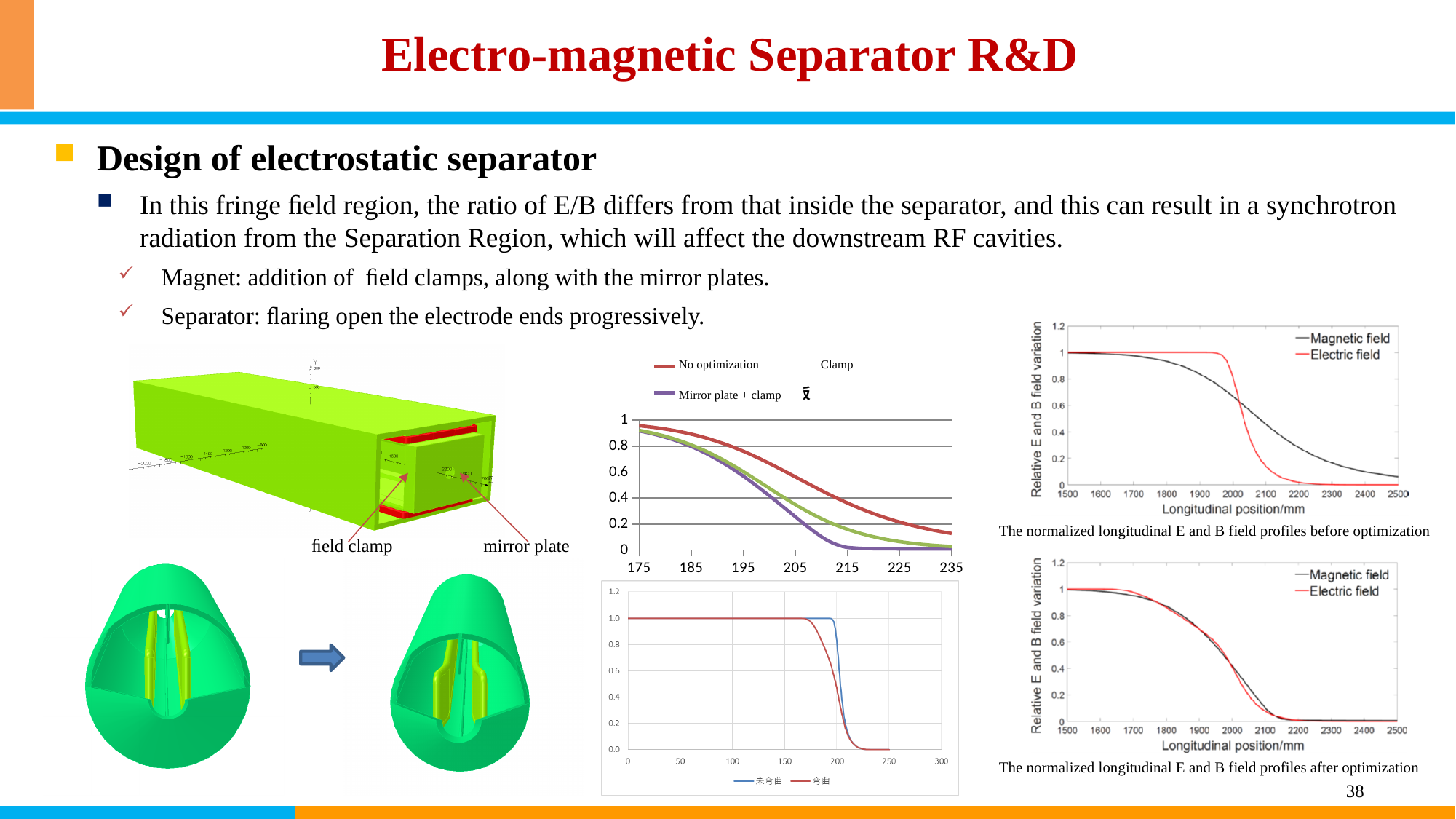
In the chart 'The normalized longitudinal E and B field profiles after optimization', is the Electric field value at 1600 mm greater or less than 0.8? greater In the middle chart with x axis from 175 to 235, which series has the larger value at 205: 'No optimization' or 'Mirror plate + clamp'? No optimization In the middle chart with x axis from 175 to 235, is the value of 'No optimization' at 175 greater or less than 0.8? greater How many series does the legend list in the middle chart with x axis from 175 to 235? 3 How many series does the legend list in the chart titled 'The normalized longitudinal E and B field profiles before optimization'? 2 In the chart 'The normalized longitudinal E and B field profiles before optimization', which series has the larger value at longitudinal position 2100 mm: Magnetic field or Electric field? Magnetic field What is the x-axis label of the chart titled 'The normalized longitudinal E and B field profiles after optimization'? Longitudinal position/mm In the middle chart with x axis from 175 to 235, do the values rise or fall as x increases? fall In the middle chart with x axis from 175 to 235, which colour is used for the 'No optimization' series? red In the chart 'The normalized longitudinal E and B field profiles before optimization', is the Magnetic field value at 2400 mm greater or less than 0.2? less What kind of chart is the middle chart with the legend entries 'No optimization', 'Clamp' and 'Mirror plate + clamp'? line chart